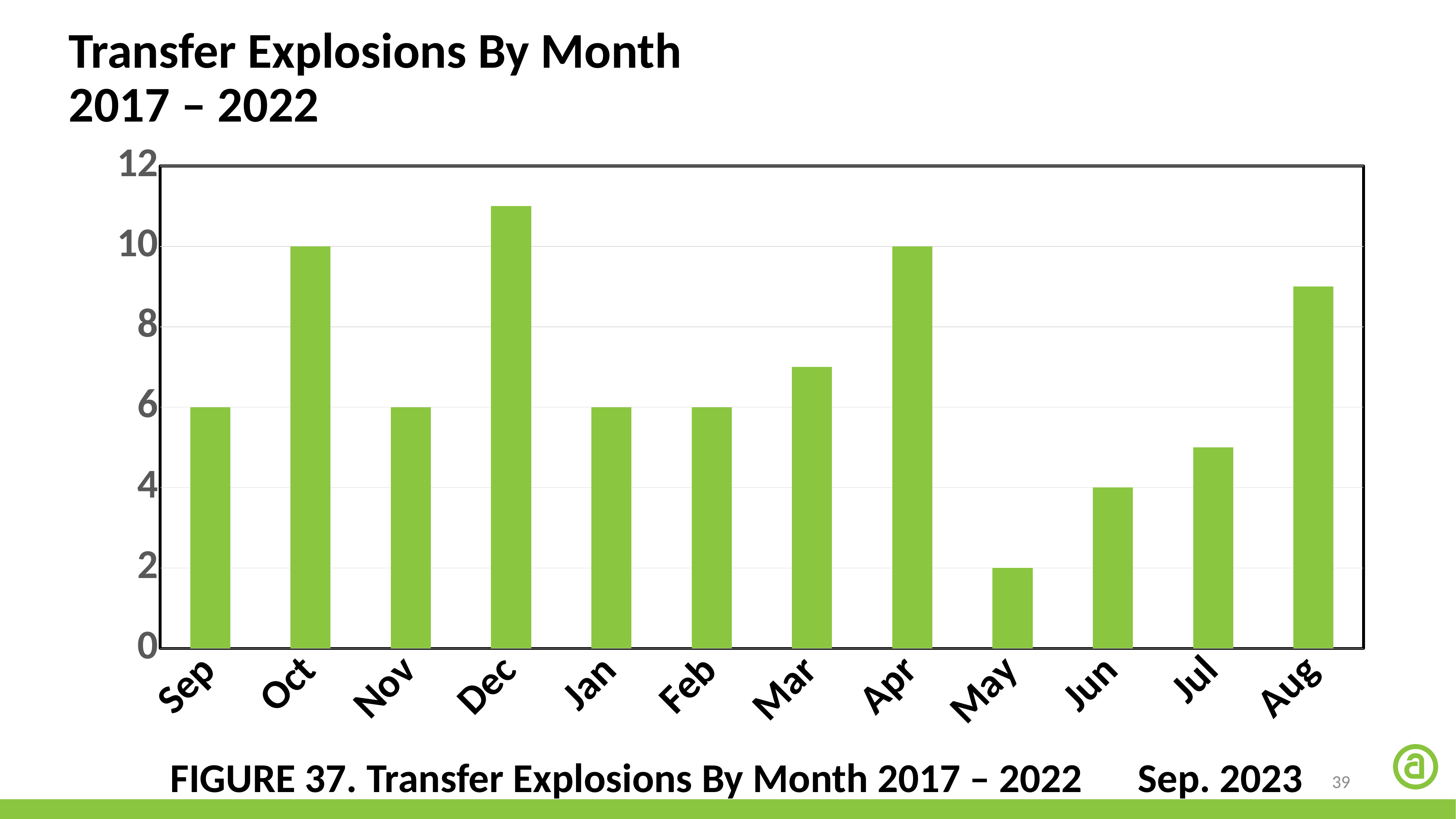
Which is larger, the value for Apr or the value for Jun? Apr What is the value for Sep? 6 Which month has the lowest number of transfer explosions? May Which month has the highest number of transfer explosions? Dec What is the value for May? 2 What is the value for Jun? 4 Is the value for Dec greater or less than 10? greater How many months are shown on the x axis of the chart? 12 What is the difference between the values for Oct and Sep? 4 What type of chart is shown on the slide? bar chart Is the value for Aug greater or less than 8? greater What is the value for Oct? 10